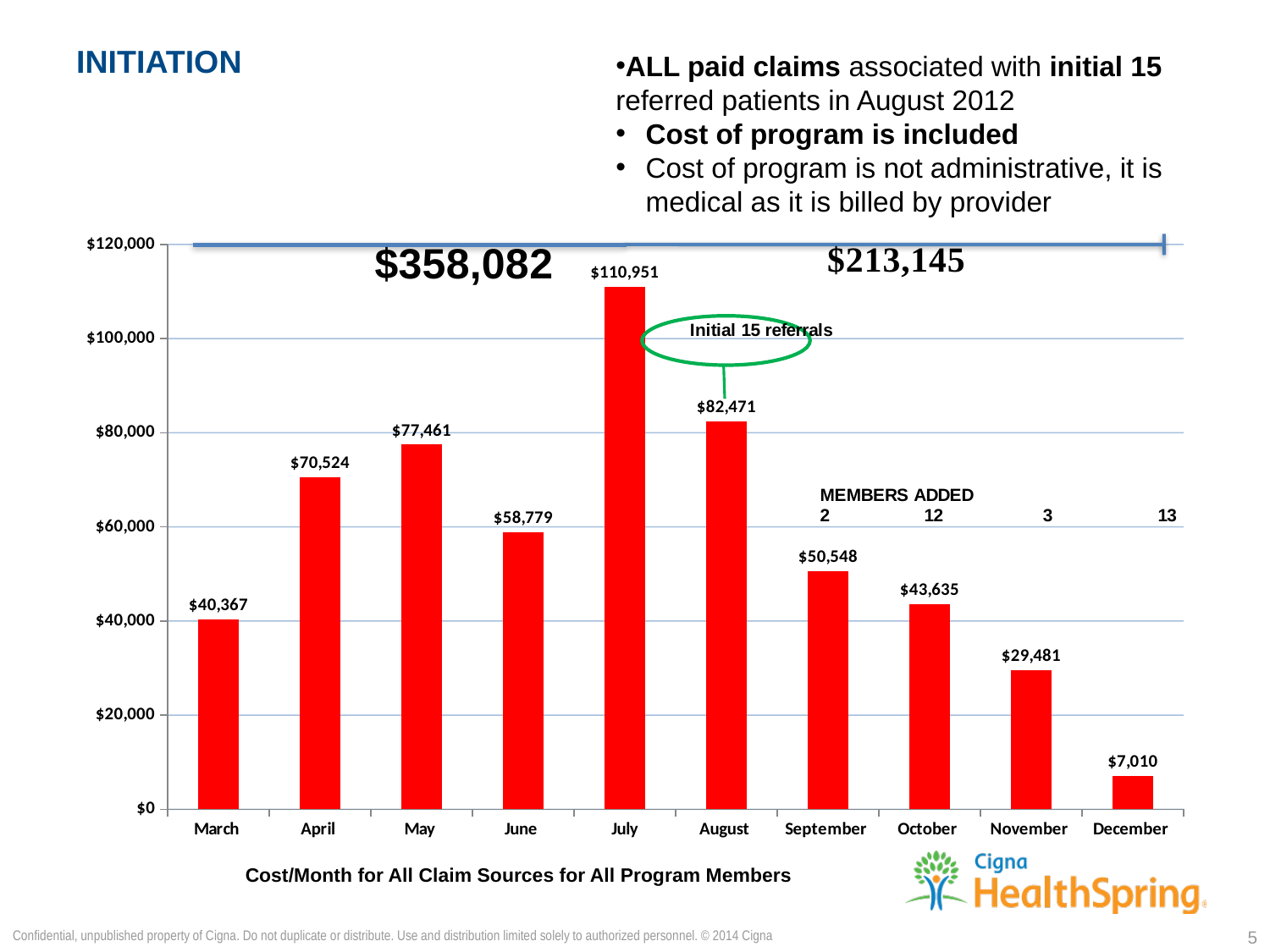
Which month has the lowest value? December What is the difference between the values for July and August? $28,480 Is the value for June greater or less than $60,000? less What is the value for July? $110,951 Which is larger, the value for May or the value for April? May What is the value for December? $7,010 What is the value for August? $82,471 Do the values rise or fall from August to December? fall What kind of chart is shown on the slide? bar chart Which month has the highest value? July What is the value for March? $40,367 How many months are shown on the x axis? 10